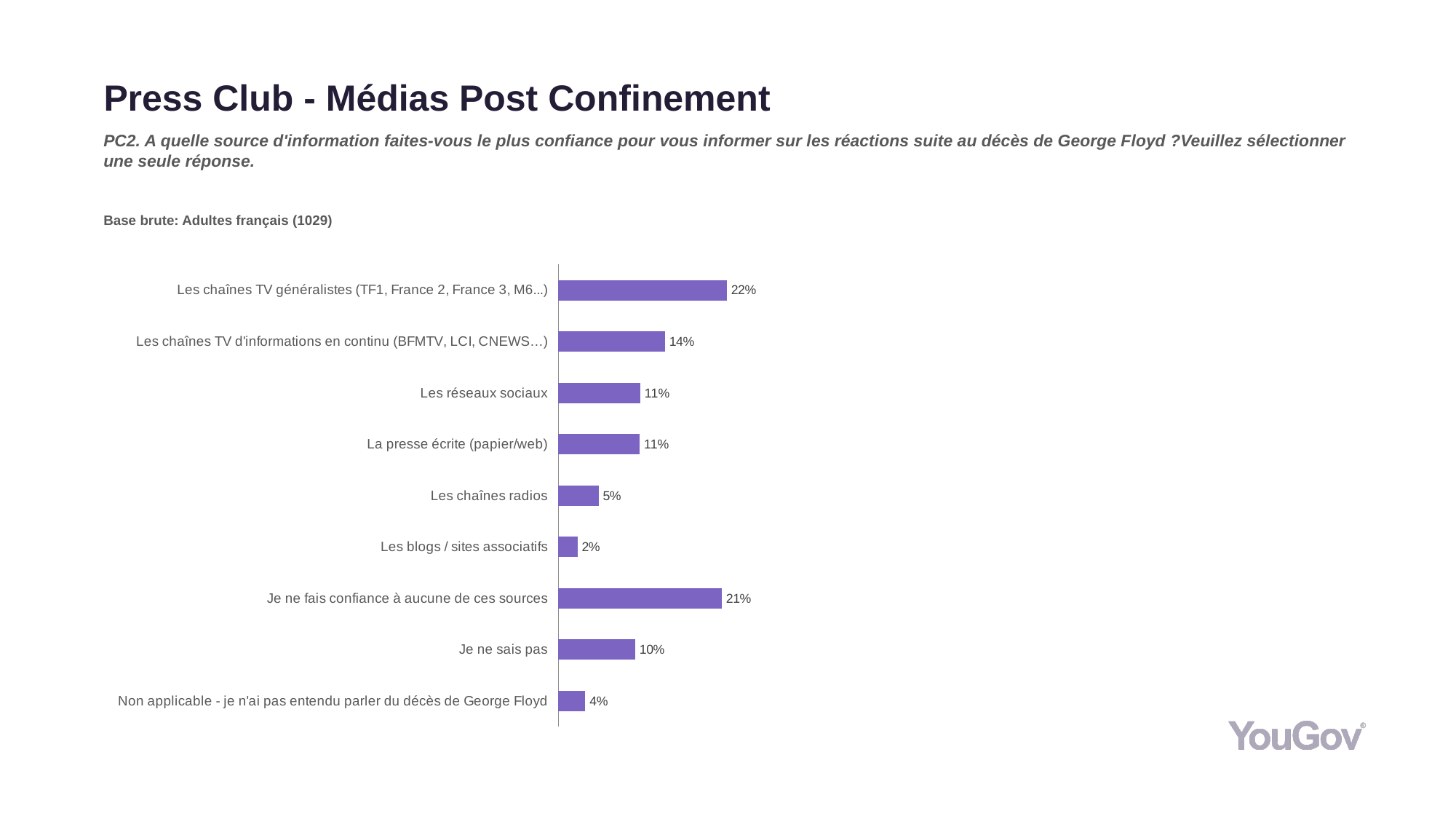
What is the base (sample) stated on the slide? Adultes français (1029) Which category has the lowest value? Les blogs / sites associatifs What is the difference between the values for "Les chaînes TV d'informations en continu (BFMTV, LCI, CNEWS…)" and "Les chaînes radios"? 9% Which is larger: the value for "Les réseaux sociaux" or the value for "Les chaînes radios"? Les réseaux sociaux What is the difference between the values for "Les chaînes TV généralistes (TF1, France 2, France 3, M6...)" and "Je ne fais confiance à aucune de ces sources"? 1% What kind of chart is shown on the slide? Bar chart What is the value for "Les chaînes TV d'informations en continu (BFMTV, LCI, CNEWS…)"? 14% Which category has the highest value? Les chaînes TV généralistes (TF1, France 2, France 3, M6...) How many categories are shown in the chart? 9 What is the value for "Les chaînes TV généralistes (TF1, France 2, France 3, M6...)"? 22% What is the value for "Non applicable - je n'ai pas entendu parler du décès de George Floyd"? 4% What is the value for "Je ne sais pas"? 10%